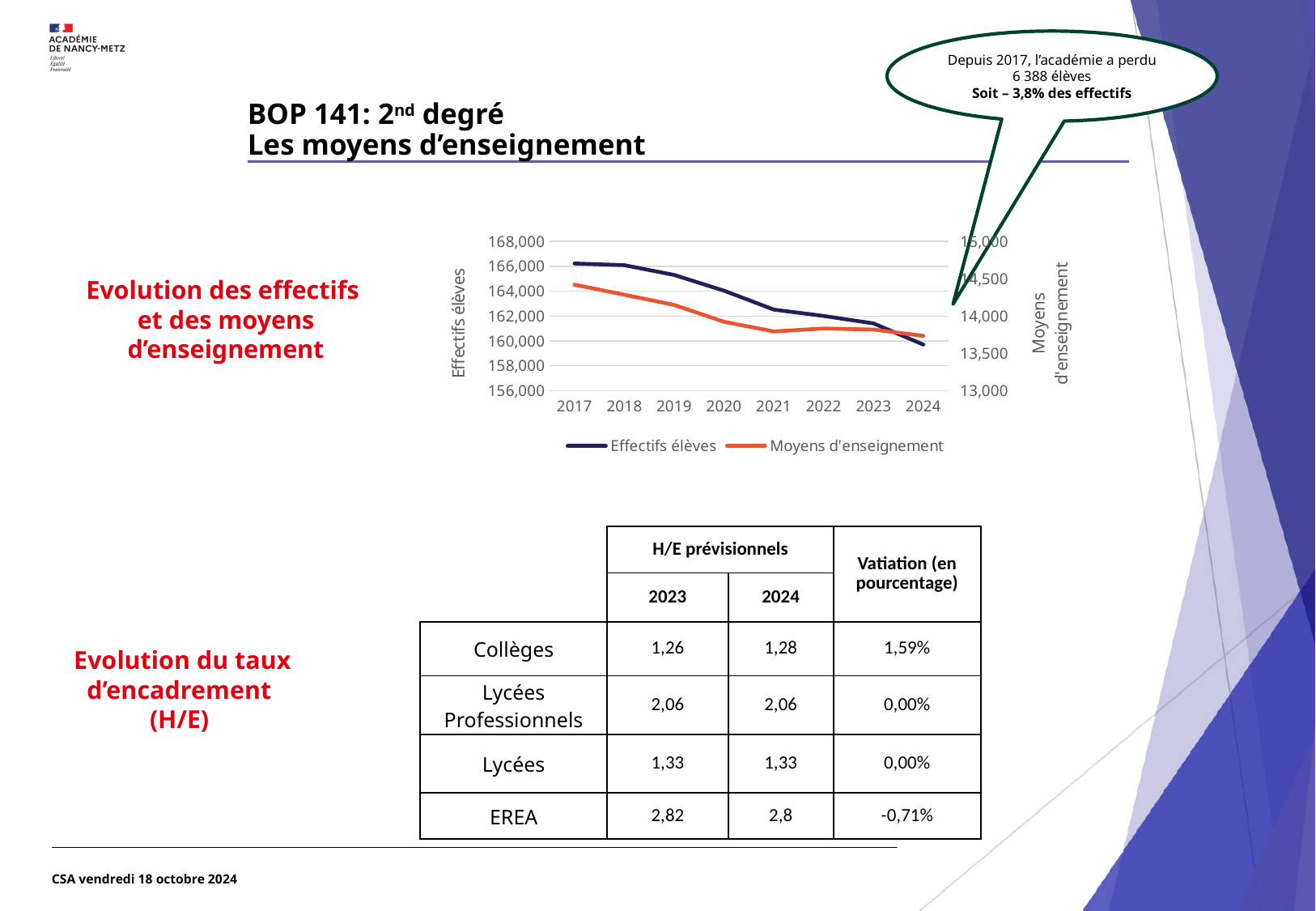
Do the values for Moyens d'enseignement rise or fall overall from 2017 to 2024? fall Is the value for Effectifs élèves in 2024 greater or less than 162,000? less Is the value for Effectifs élèves in 2017 greater or less than 164,000? greater Do the values for Effectifs élèves rise or fall from 2017 to 2024? fall Which series is drawn in orange in the chart? Moyens d'enseignement How many series does the chart legend list? 2 Is the value for Moyens d'enseignement in 2017 greater or less than 14,000? greater What is the title of the left vertical axis of the chart? Effectifs élèves What kind of chart is shown on the slide? line chart How many years are plotted along the x axis of the chart? 8